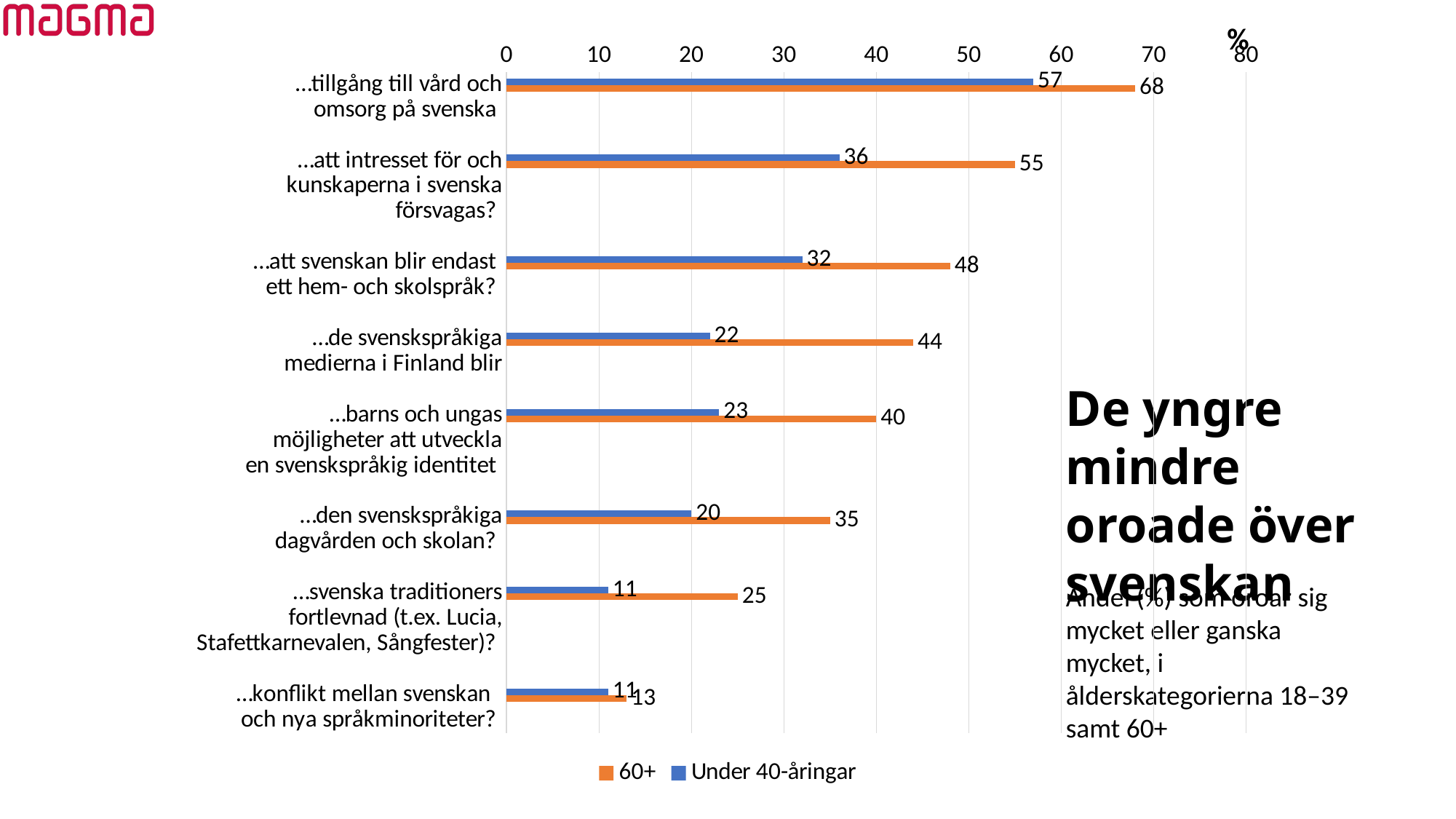
What is the value for the 60+ series for "...tillgång till vård och omsorg på svenska"? 68 Which category has the lowest value for the 60+ series? ...konflikt mellan svenskan och nya språkminoriteter? How many categories are shown on the chart? 8 What is the difference between the 60+ and Under 40-åringar values for "...att intresset för och kunskaperna i svenska försvagas?"? 19 What is the value for the Under 40-åringar series for "...att svenskan blir endast ett hem- och skolspråk?"? 32 How many series does the legend list? 2 For "...barns och ungas möjligheter att utveckla en svenskspråkig identitet", which series has the larger value, 60+ or Under 40-åringar? 60+ What is the value for the 60+ series for "...den svenskspråkiga dagvården och skolan?"? 35 Which category has the highest value for the 60+ series? ...tillgång till vård och omsorg på svenska Which colour represents the 60+ series in the chart? Orange What kind of chart is shown on the slide? Bar chart What is the difference between the 60+ and Under 40-åringar values for "...de svenskspråkiga medierna i Finland blir"? 22